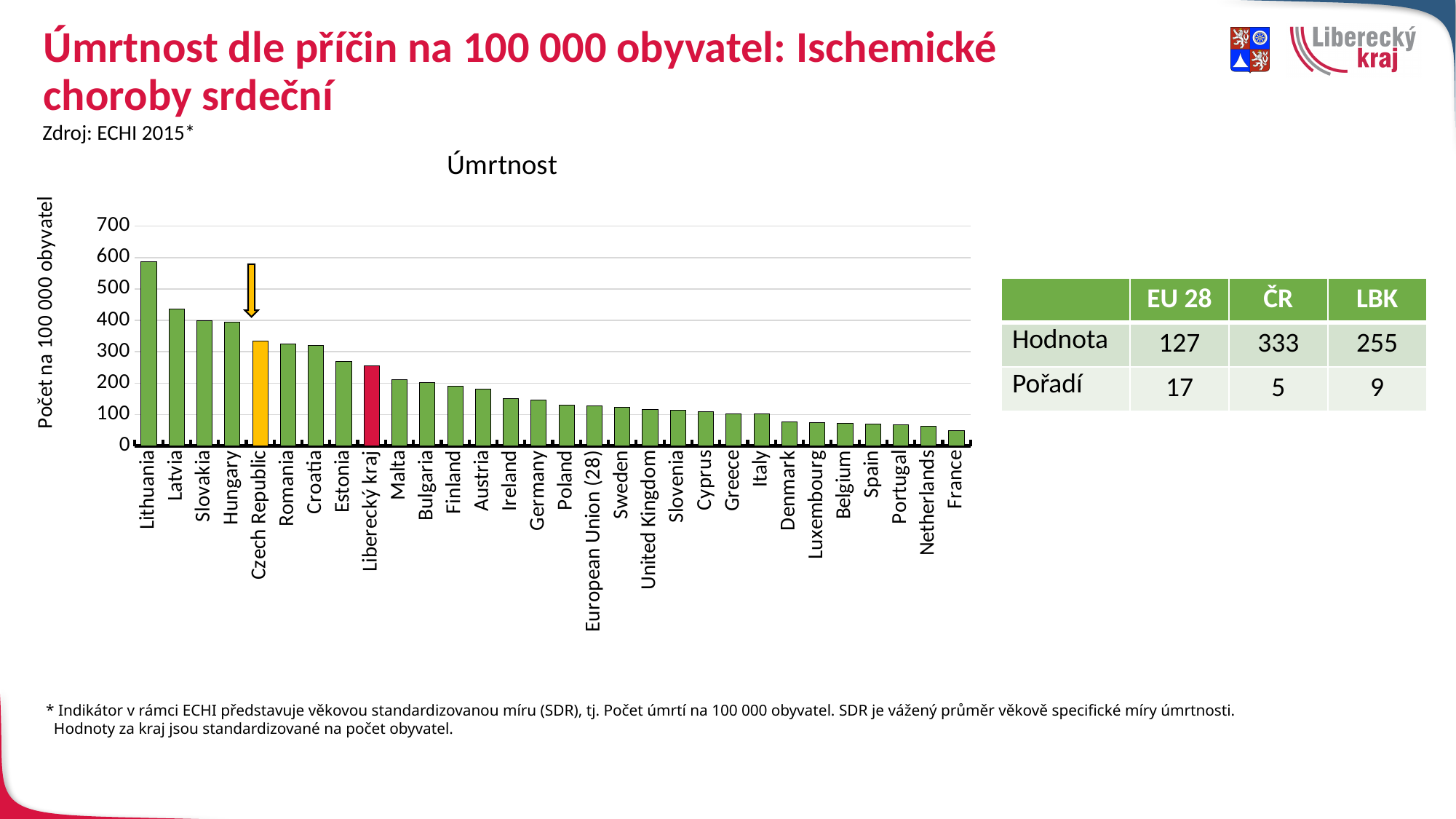
Which country has the highest mortality value in the chart? Lithuania What is the difference between the values for ČR and LBK shown in the table? 78 Is the value for Lithuania greater or less than 500? greater What type of chart is shown on the slide? bar chart Which country has the lowest mortality value in the chart? France What is the value for Czech Republic (ČR) according to the table? 333 Which has the larger value, Latvia or Slovakia? Latvia Is the value for Estonia greater or less than 300? less Do the values rise or fall moving from left to right along the x axis? fall What is the value for EU 28 according to the table? 127 What is the value for Liberecký kraj (LBK) according to the table? 255 How many categories (bars) are plotted in the chart? 30